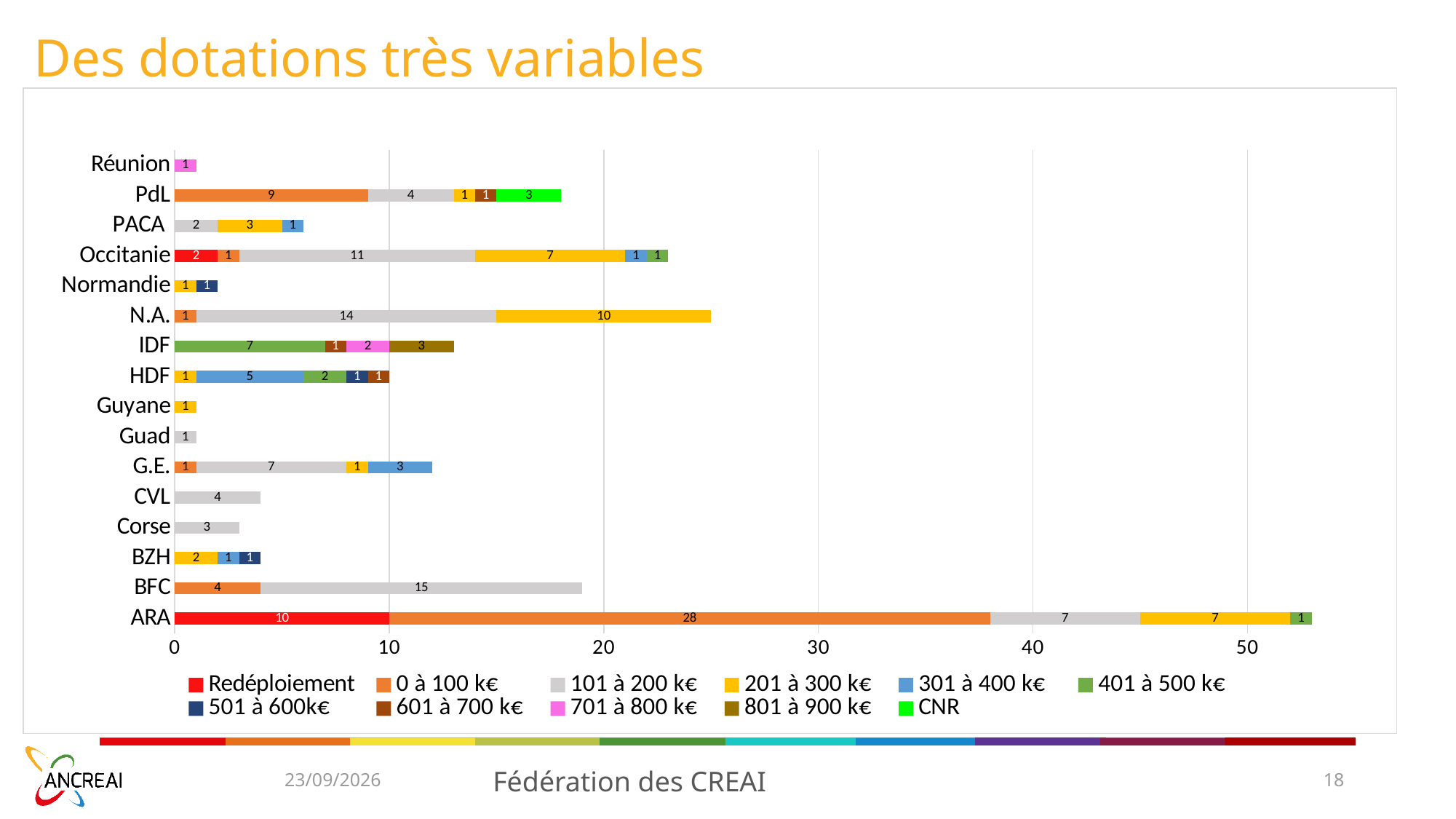
What is the total of the stacked bar for ARA? 53 How many series does the legend list? 11 Is the total bar for BFC greater or less than 10? greater Which region has the longest total bar? ARA What kind of chart is shown on the slide? Stacked bar chart What is the value of the '0 à 100 k€' segment for ARA? 28 What is the value of the '101 à 200 k€' segment for N.A.? 14 What is the total of the stacked bar for Occitanie? 23 What is the value of the 'CNR' segment for PdL? 3 What is the difference between the '101 à 200 k€' values for BFC and Occitanie? 4 How many regions (categories) are plotted on the chart? 16 Which is larger: the '201 à 300 k€' value for N.A. or for Occitanie? N.A.